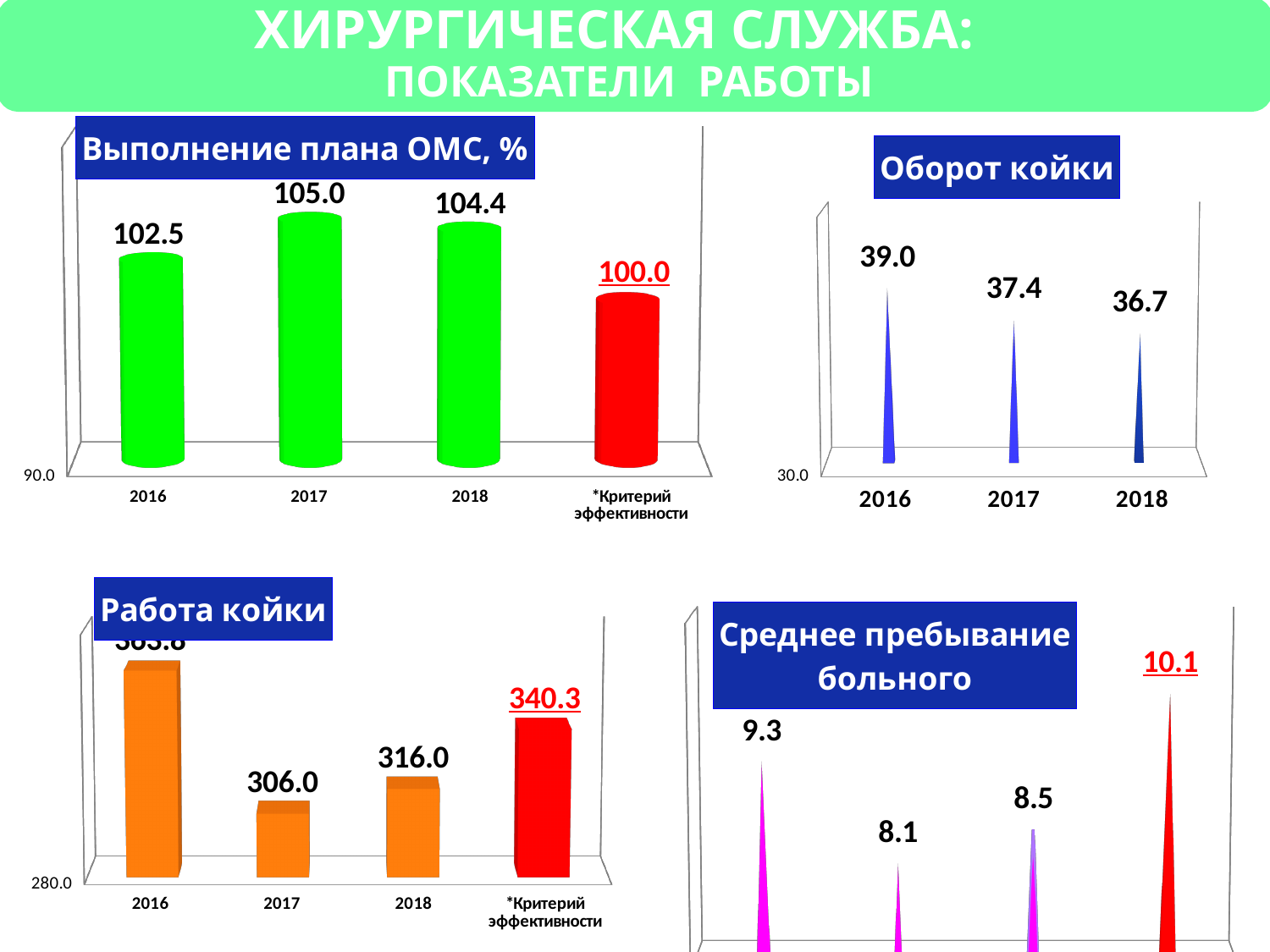
In the chart 'Работа койки', which is larger, the value for 2017 or the value for 2018? 2018 In the chart 'Оборот койки', do the values rise or fall from 2016 to 2018? fall In the chart 'Оборот койки', how many years are shown? 3 In the chart 'Работа койки', what is the value for 2018? 316.0 In the chart 'Среднее пребывание больного', what is the lowest value shown? 8.1 In the chart 'Среднее пребывание больного', what is the value shown on the red bar? 10.1 In the chart 'Выполнение плана ОМС, %', what is the difference between the 2017 value and the 'Критерий эффективности' value? 5.0 In the chart 'Работа койки', what is the value for 'Критерий эффективности'? 340.3 In the chart 'Оборот койки', what is the value for 2018? 36.7 In the chart 'Выполнение плана ОМС, %', which year has the lowest value? 2016 In the chart 'Выполнение плана ОМС, %', what is the value for 2017? 105.0 What kind of chart is 'Выполнение плана ОМС, %'? bar chart